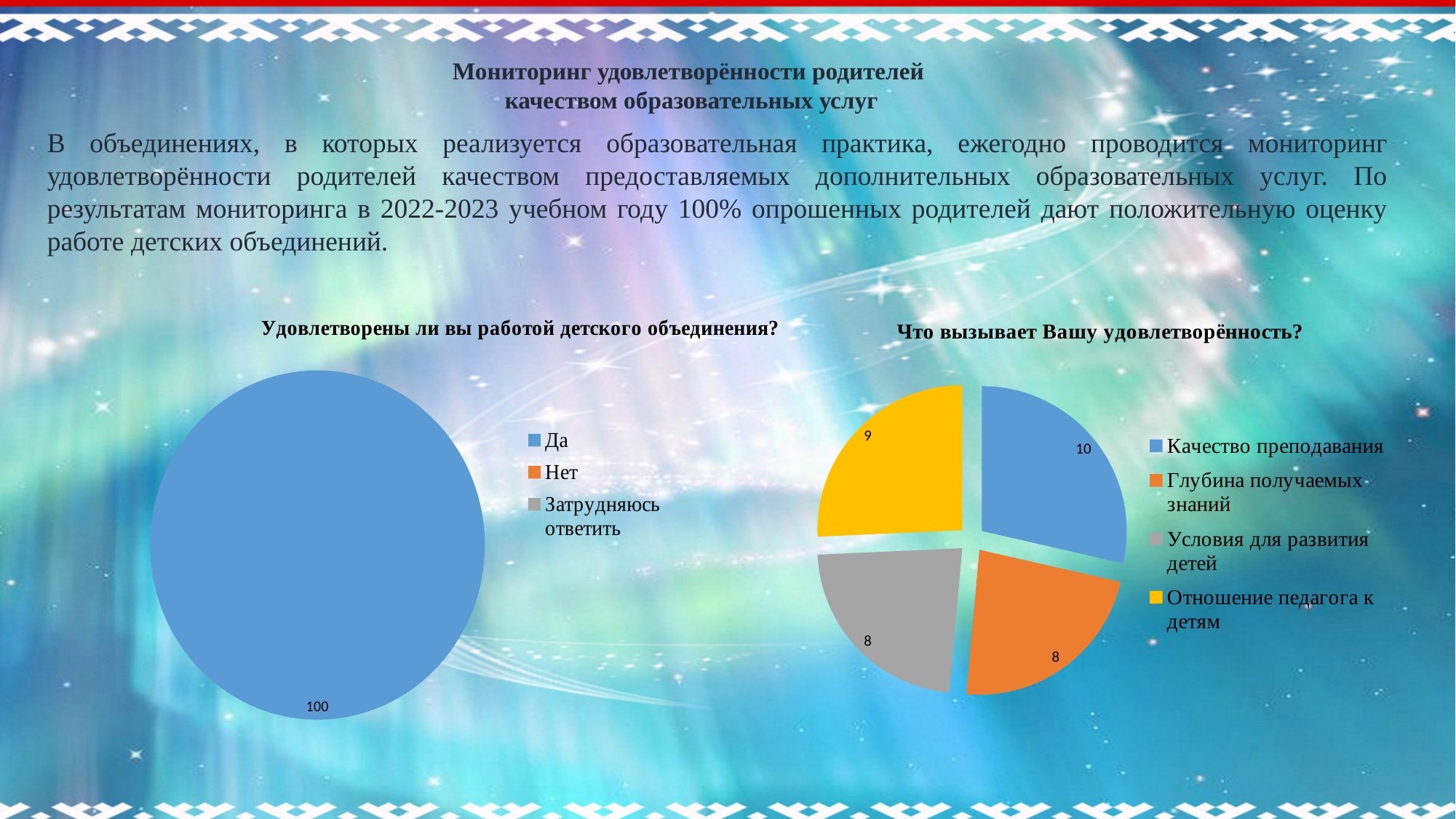
In the chart "Что вызывает Вашу удовлетворённость?", what colour is the slice for "Отношение педагога к детям"? yellow In the chart "Что вызывает Вашу удовлетворённость?", which category has the highest value? Качество преподавания In the chart "Удовлетворены ли вы работой детского объединения?", what value is shown for "Да"? 100 How many entries does the legend of the chart "Удовлетворены ли вы работой детского объединения?" list? 3 How many slices does the chart "Что вызывает Вашу удовлетворённость?" have? 4 In the chart "Что вызывает Вашу удовлетворённость?", what value is shown for "Отношение педагога к детям"? 9 In the chart "Что вызывает Вашу удовлетворённость?", what value is shown for "Качество преподавания"? 10 In the chart "Что вызывает Вашу удовлетворённость?", what is the total of all slice values? 35 In the chart "Что вызывает Вашу удовлетворённость?", what value is shown for "Глубина получаемых знаний"? 8 In the chart "Что вызывает Вашу удовлетворённость?", which is larger: "Отношение педагога к детям" or "Глубина получаемых знаний"? Отношение педагога к детям What kind of chart is the chart titled "Удовлетворены ли вы работой детского объединения?"? pie chart In the chart "Что вызывает Вашу удовлетворённость?", what is the difference between the values for "Качество преподавания" and "Условия для развития детей"? 2